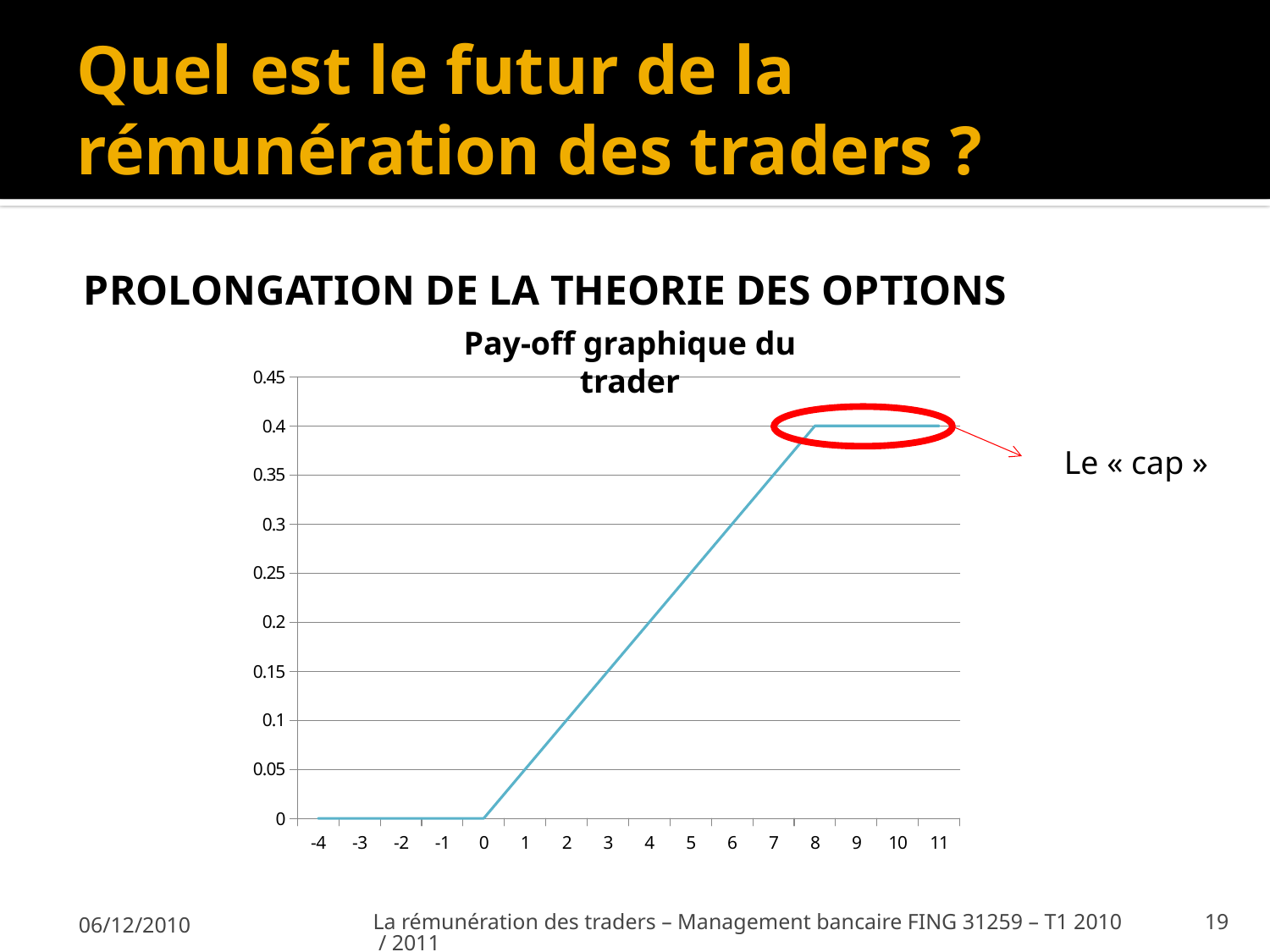
Is the value of the pay-off at x = 2 greater or less than 0.15? less Is the value of the pay-off at x = 6 greater or less than 0.25? greater What is the value of the pay-off at x = 8? 0.4 What is the value of the pay-off at x = 11? 0.4 What label does the red arrow annotation give to the flat part of the line at 0.4? Le « cap » What is the value of the pay-off at x = 0? 0 What kind of chart is shown on the slide? line chart What is the highest value reached by the pay-off line? 0.4 Which is larger, the pay-off at x = 3 or the pay-off at x = 7? x = 7 What is the title of the chart? Pay-off graphique du trader What is the value of the pay-off at x = 4? 0.2 How many x-axis categories are shown on the chart? 16